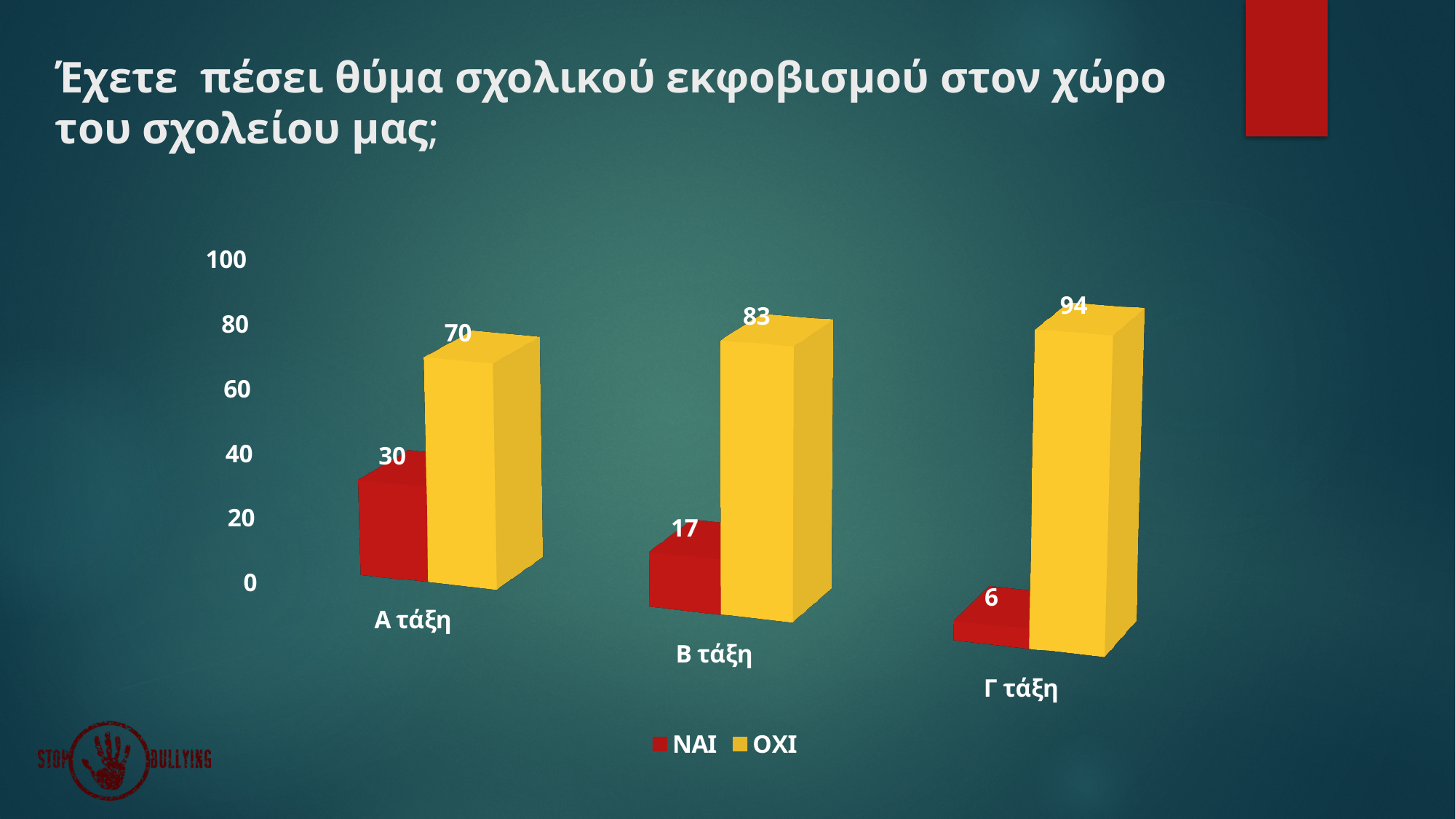
Which category has the lowest ΝΑΙ value? Γ τάξη How many categories are shown on the x axis? 3 What is the value for ΝΑΙ in Γ τάξη? 6 Which colour represents the ΟΧΙ series? yellow What is the difference between the ΟΧΙ and ΝΑΙ values in Α τάξη? 40 What kind of chart is shown on the slide? bar chart Which is larger: the ΝΑΙ value for Α τάξη or the ΝΑΙ value for Β τάξη? Α τάξη What is the value for ΟΧΙ in Β τάξη? 83 Which category has the highest ΟΧΙ value? Γ τάξη Is the ΟΧΙ value for Γ τάξη greater or less than 80? greater What is the value for ΝΑΙ in Α τάξη? 30 How many series does the legend list? 2